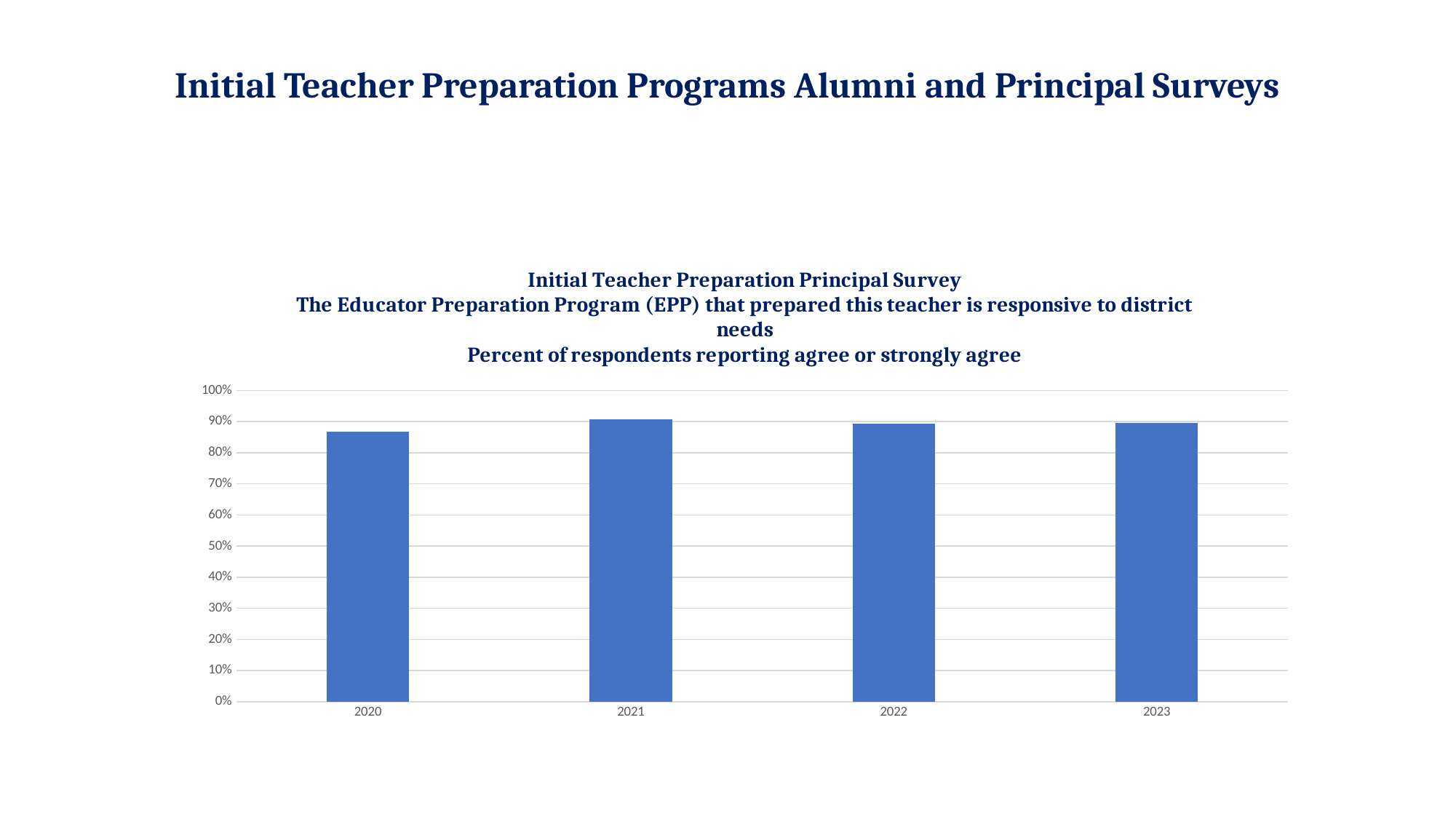
Which is larger, the value for 2020 or the value for 2022? 2022 Is the value for 2023 greater or less than 80%? greater What is the first year shown on the x axis of the chart? 2020 Is the value for 2020 greater or less than 90%? less Which year has the lowest bar in the chart? 2020 What kind of chart is shown on the slide? bar chart Is the value for 2022 greater or less than 80%? greater Did the value rise or fall from 2020 to 2021? rise Which is larger, the value for 2020 or the value for 2021? 2021 How many years are shown on the x axis of the chart? 4